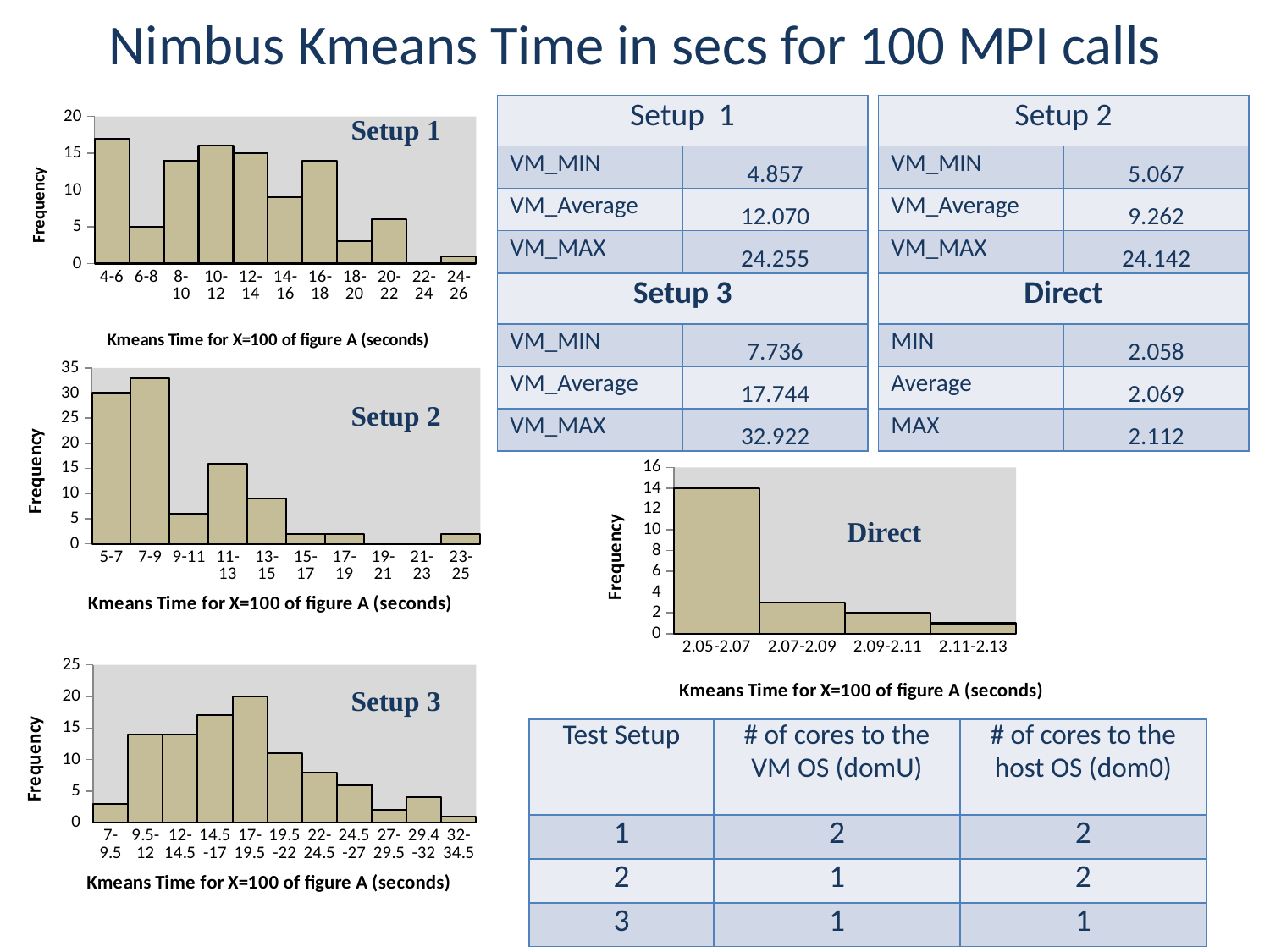
In the Direct chart, what is the frequency for the 2.05-2.07 bin? 14 In the Setup 2 chart, what is the frequency for the 5-7 bin? 30 In the Setup 3 chart, which time bin has the highest frequency? 17-19.5 In the Setup 1 chart, what is the frequency for the 6-8 bin? 5 In the Setup 2 chart, which time bin has the highest frequency? 7-9 In the Setup 1 chart, which time bin has the highest frequency? 4-6 In the Direct chart, do the frequencies rise or fall from left to right along the x axis? fall How many time bins are shown on the x axis of the Direct chart? 4 What kind of chart is the Setup 1 chart? bar chart How many time bins are shown on the x axis of the Setup 2 chart? 10 In the Setup 1 chart, is the frequency for the 4-6 bin greater or less than 15? greater